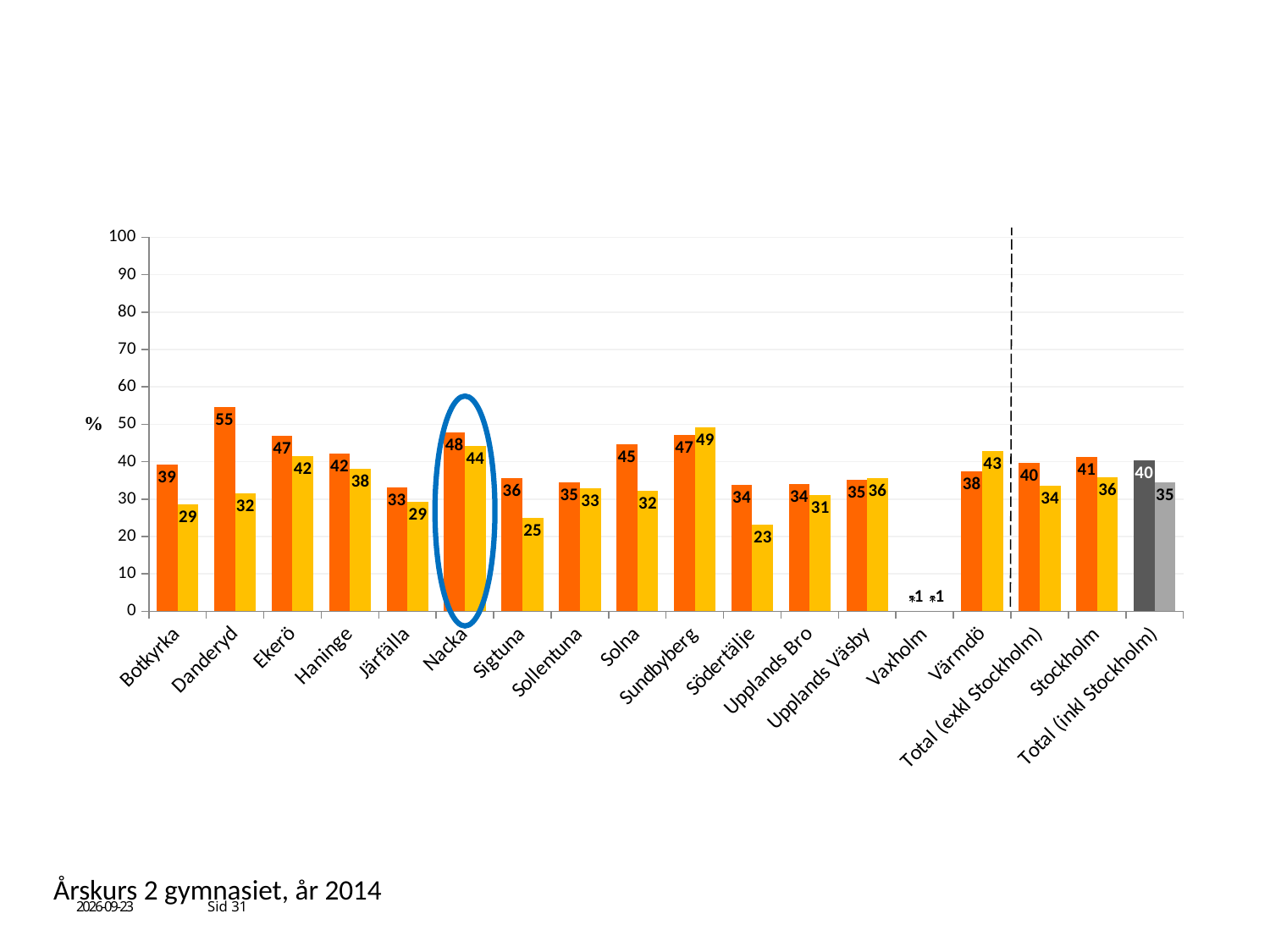
How many categories are shown on the x axis? 18 Which municipality has the lowest yellow (right) bar among those with a numeric label? Södertälje What is the value of the orange (left) bar for Danderyd? 55 What is the difference between the orange and yellow bars for Sigtuna? 11 What kind of chart is shown on the slide? bar chart What is the value of the yellow (right) bar for Nacka? 44 Which municipality has the highest orange (left) bar? Danderyd Which municipality is circled in blue on the chart? Nacka Which is larger for Sundbyberg, the orange (left) bar or the yellow (right) bar? the yellow (right) bar What is the value of the yellow (right) bar for Södertälje? 23 Is the orange (left) bar for Danderyd greater or less than 50? greater What is the value of the dark grey bar for Total (inkl Stockholm)? 40